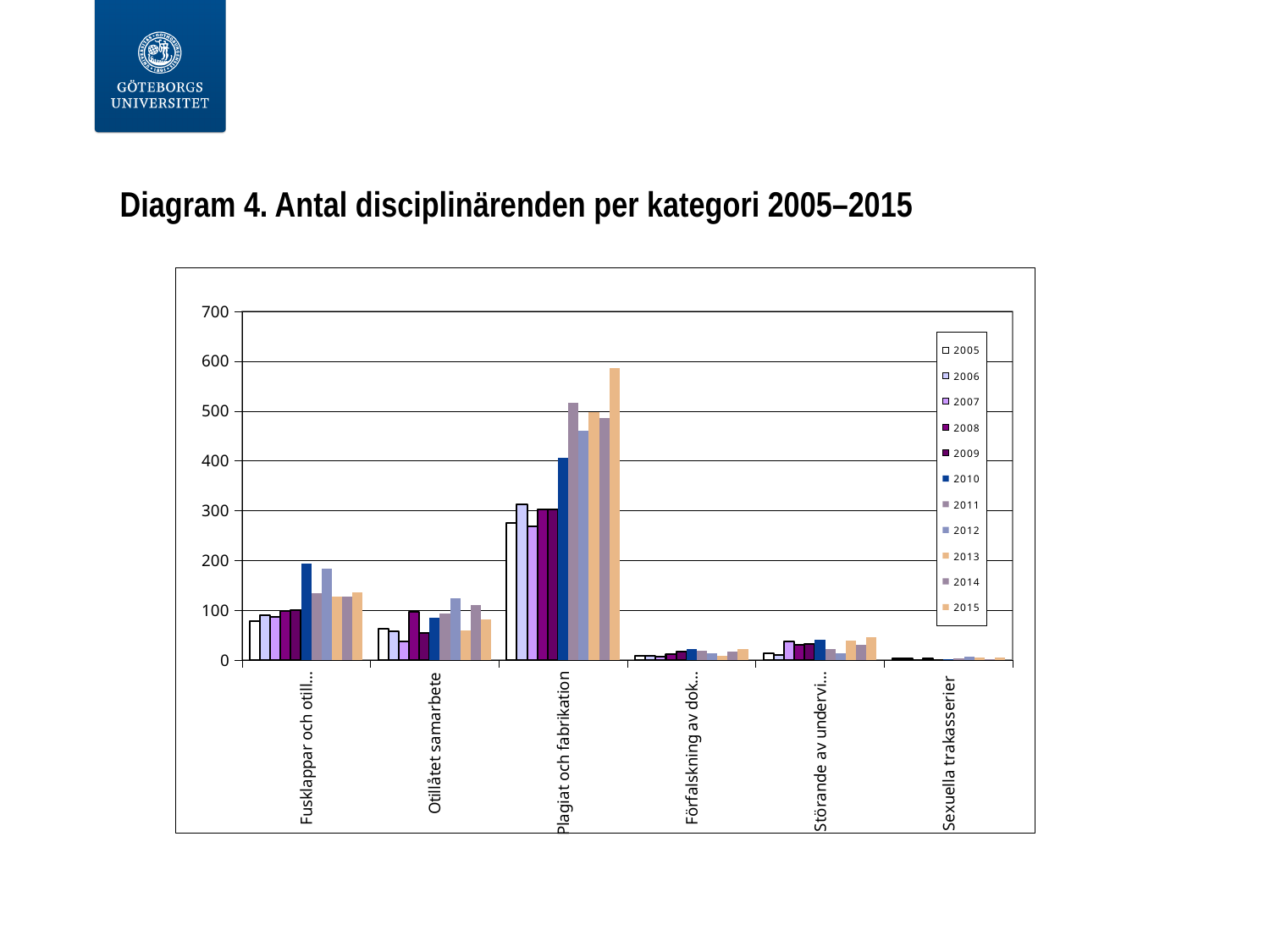
How many series does the legend list? 11 For 2010, which is larger: Fusklappar och otill... or Otillåtet samarbete? Fusklappar och otill... Is the value for 2010 in the Fusklappar och otill... category greater or less than 150? greater Is the value for 2005 in the Plagiat och fabrikation category greater or less than 300? less Which category has the lowest bars overall? Sexuella trakasserier What kind of chart is shown on the slide? Bar chart What is the title of the chart? Diagram 4. Antal disciplinärenden per kategori 2005–2015 Which category has the highest bars overall? Plagiat och fabrikation Which year has the tallest bar in the Plagiat och fabrikation category? 2015 Is the value for 2015 in the Plagiat och fabrikation category greater or less than 500? greater How many categories are shown on the x axis? 6